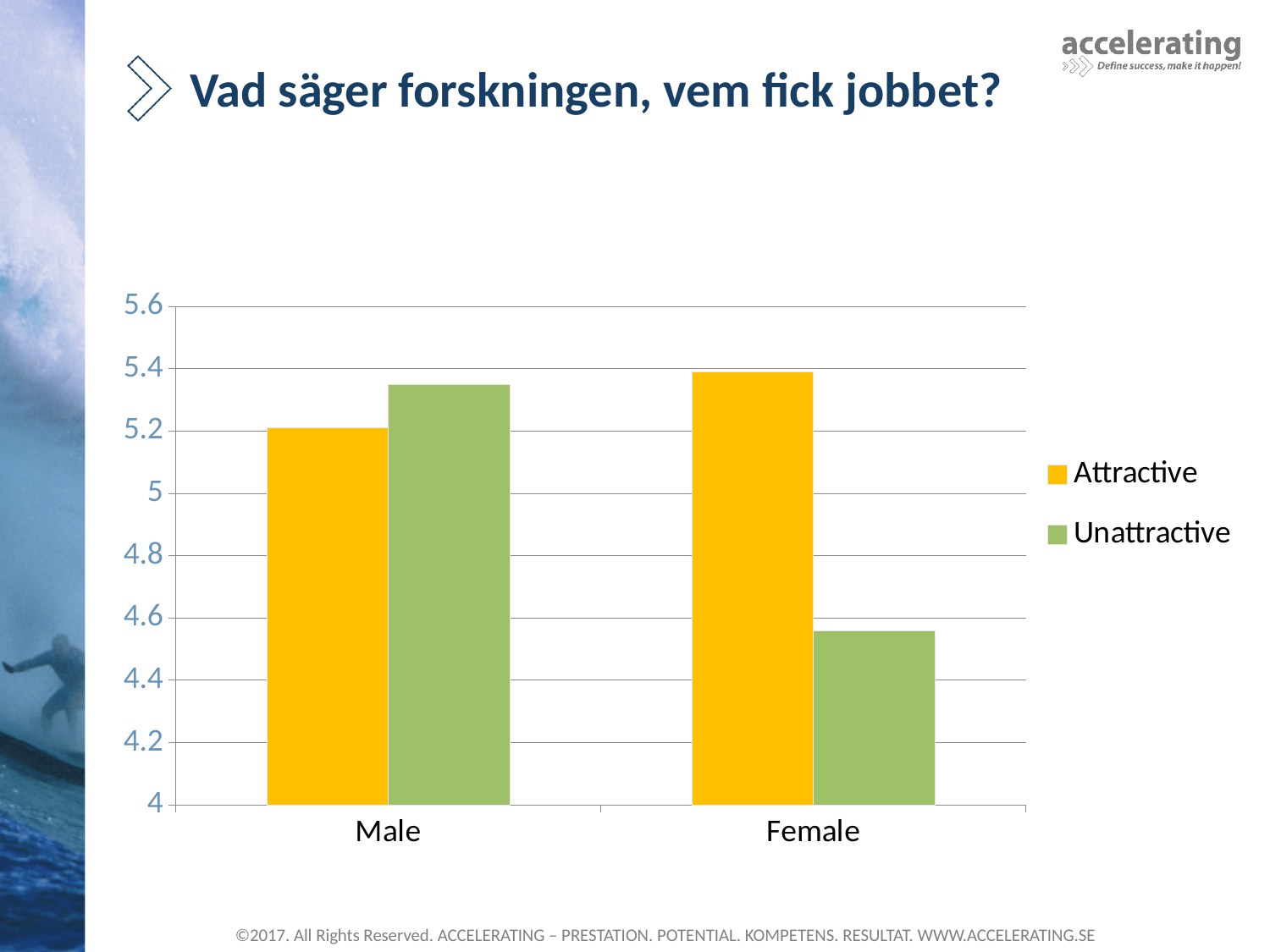
What are the two entries listed in the chart's legend? Attractive and Unattractive What kind of chart is shown on the slide? bar chart Is the Unattractive value for Male greater or less than 5.2? greater Is the Attractive value for Male greater or less than 5? greater For Male, which is larger: the Attractive value or the Unattractive value? Unattractive For Female, which is larger: the Attractive value or the Unattractive value? Attractive Which bar is the lowest in the whole chart? Female, Unattractive How many series does the chart's legend list? 2 How many categories are shown on the x axis of the chart? 2 Is the Unattractive value for Female greater or less than 4.8? less Which category has the lowest Unattractive value? Female Which is larger: the Attractive value for Male or the Unattractive value for Female? Attractive value for Male